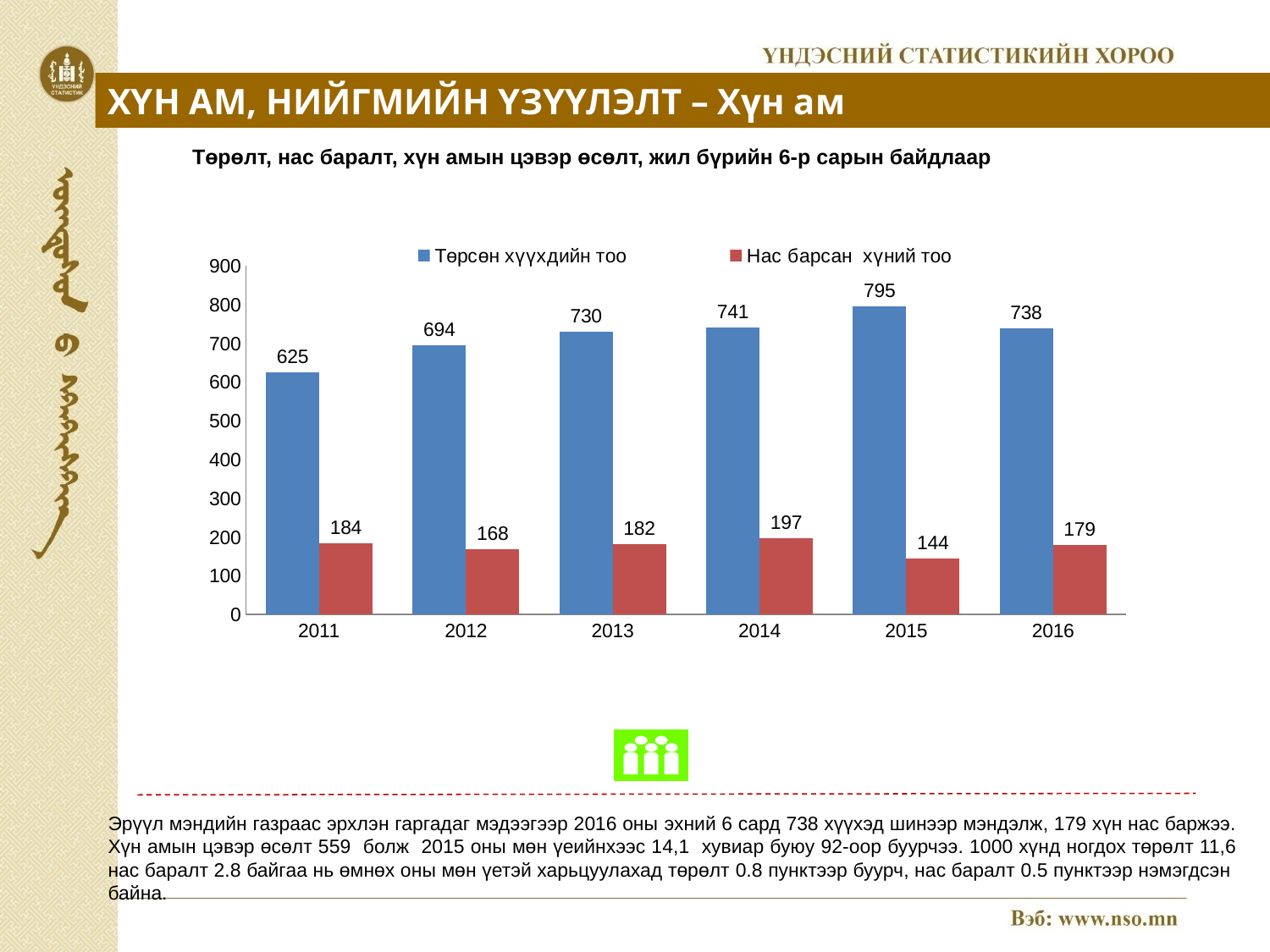
Is the value of Төрсөн хүүхдийн тоо for 2011 greater or less than 600? greater What is the value of Төрсөн хүүхдийн тоо for 2013? 730 Which year has the lowest value for Нас барсан хүний тоо? 2015 Which year has the highest value for Төрсөн хүүхдийн тоо? 2015 How many years are shown on the x axis? 6 Does Төрсөн хүүхдийн тоо rise or fall from 2011 to 2015? rise What is the value of Нас барсан хүний тоо for 2015? 144 Which is larger: Нас барсан хүний тоо in 2011 or in 2014? 2014 What colour are the bars for Нас барсан хүний тоо? red How many series does the legend list? 2 What kind of chart is shown on the slide? bar chart What is the difference between Төрсөн хүүхдийн тоо and Нас барсан хүний тоо in 2016? 559